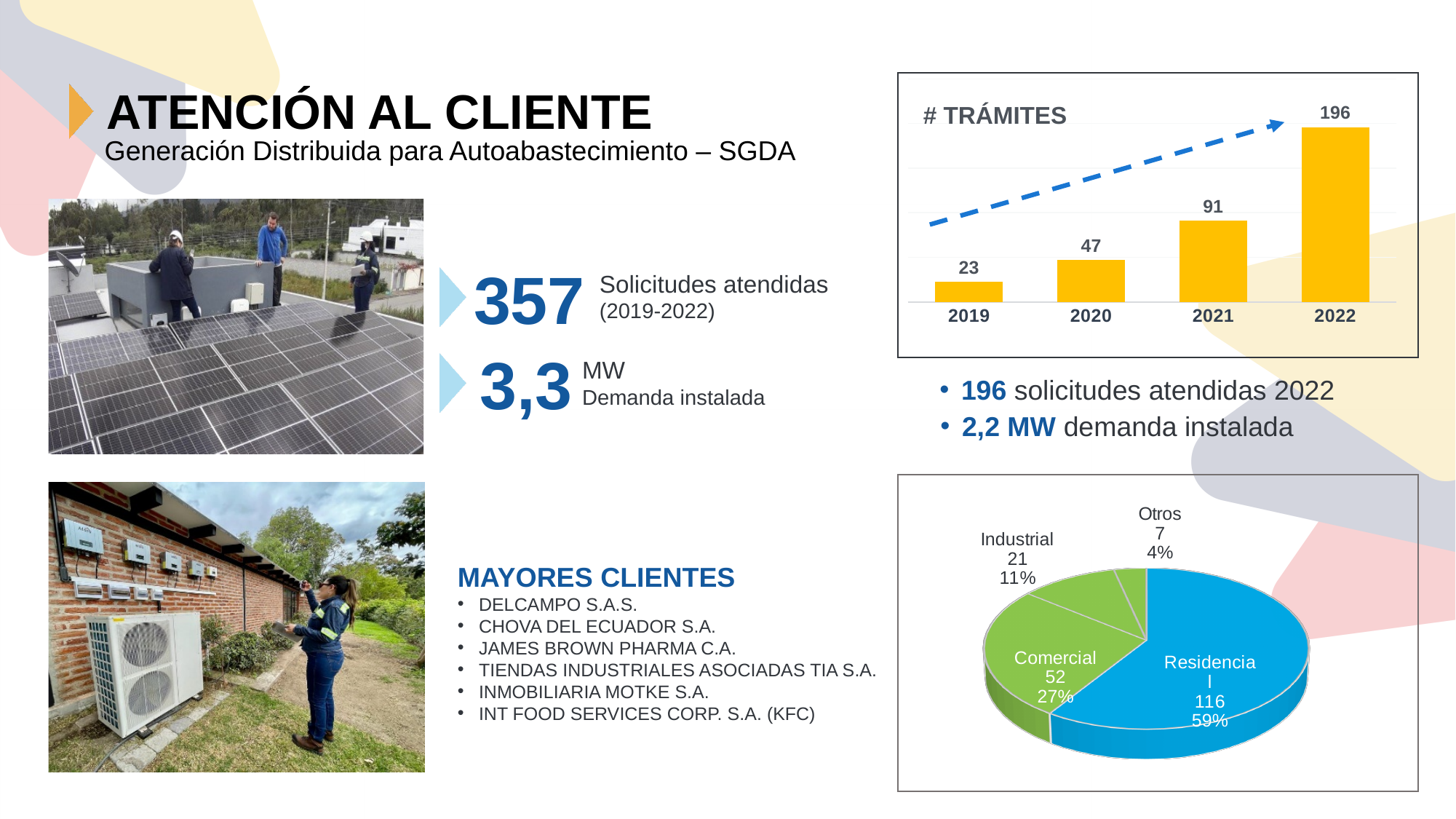
What kind of chart is the '# TRÁMITES' chart at the top right of the slide? bar chart In the '# TRÁMITES' bar chart, what is the value for 2019? 23 In the '# TRÁMITES' bar chart, which year has the highest value? 2022 In the '# TRÁMITES' bar chart, what is the value for 2021? 91 In the '# TRÁMITES' bar chart, do the values rise or fall from 2019 to 2022? rise In the '# TRÁMITES' bar chart, which year has the lowest value? 2019 In the pie chart at the bottom right, how many categories are shown? 4 In the pie chart at the bottom right, what is the value for Comercial? 52 In the '# TRÁMITES' bar chart, how many years are shown? 4 In the '# TRÁMITES' bar chart, what is the difference between the values for 2022 and 2021? 105 In the pie chart at the bottom right, which category has the smallest slice? Otros In the pie chart at the bottom right, what share does Residencial have? 59%